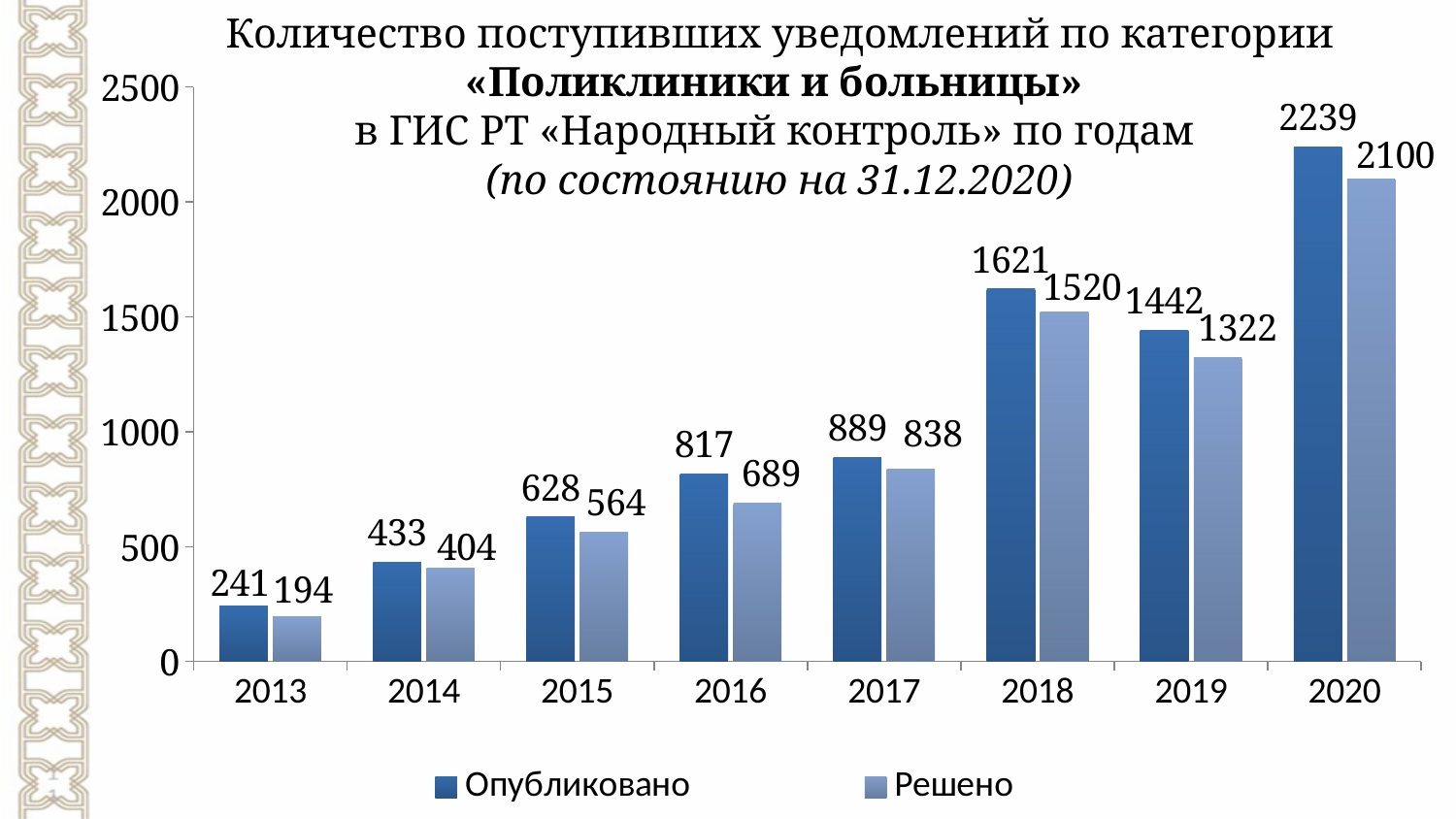
Which year has the lowest "Решено" value? 2013 What is the difference between "Опубликовано" and "Решено" in 2020? 139 Which is larger: "Опубликовано" in 2018 or "Опубликовано" in 2019? 2018 What kind of chart is shown on the slide? bar chart Is the "Решено" value for 2017 greater or less than 1000? less What is the value of "Решено" for 2015? 564 What is the value of "Опубликовано" for 2018? 1621 What are the two legend entries of the chart? Опубликовано, Решено Which year has the highest "Опубликовано" value? 2020 How many series does the legend list? 2 How many years are shown on the x axis? 8 Does the "Опубликовано" value rise or fall from 2018 to 2019? fall